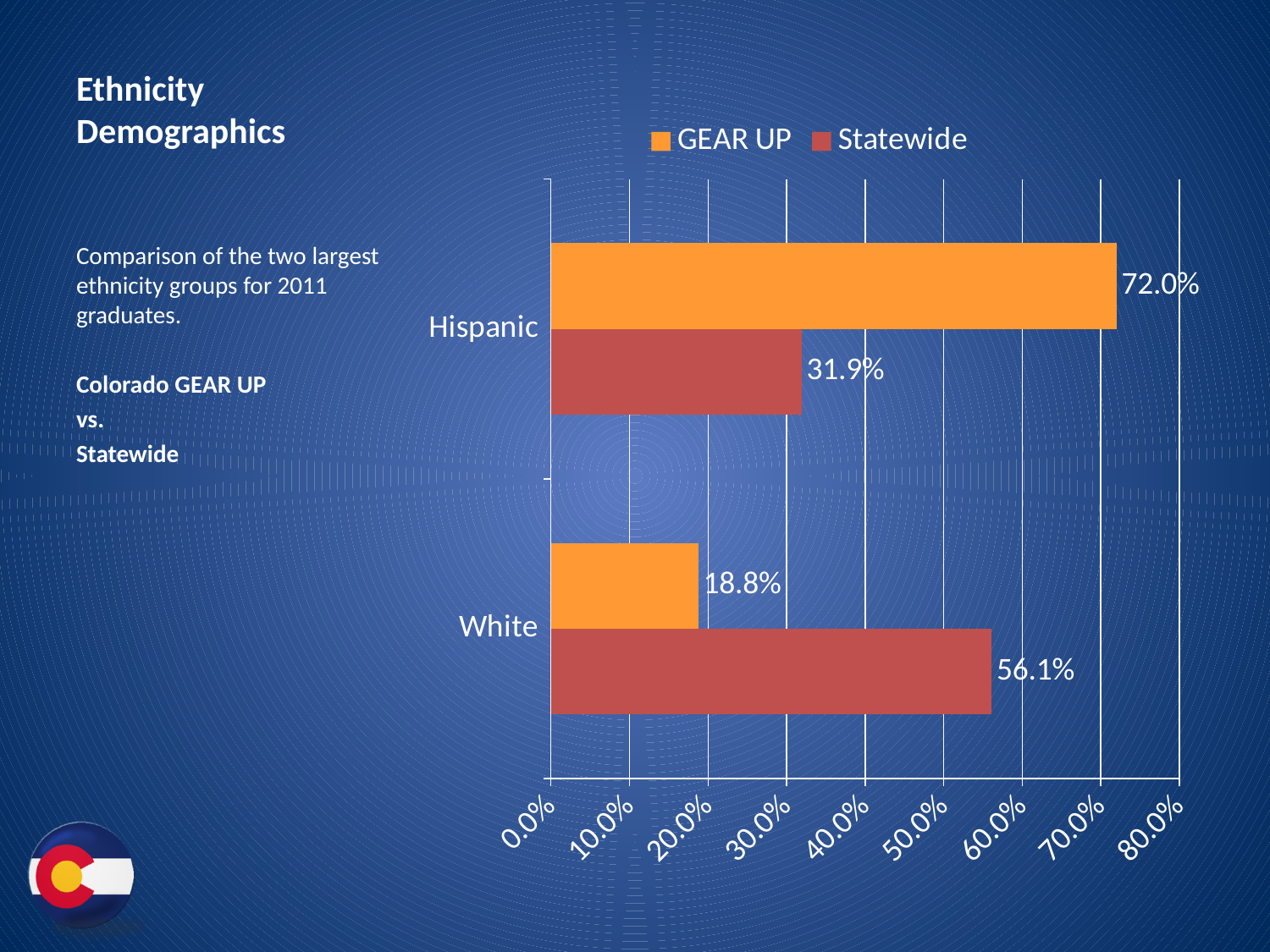
Is the GEAR UP value for Hispanic greater or less than 70.0%? greater Which category has the highest GEAR UP value? Hispanic What kind of chart is shown on the slide? bar chart What is the Statewide value for Hispanic? 31.9% Which is larger for White: the GEAR UP value or the Statewide value? Statewide How many categories are shown on the chart? 2 What is the GEAR UP value for White? 18.8% What is the Statewide value for White? 56.1% Which category has the lowest Statewide value? Hispanic How many series does the legend list? 2 What is the GEAR UP value for Hispanic? 72.0% What is the difference between the GEAR UP and Statewide values for Hispanic? 40.1%